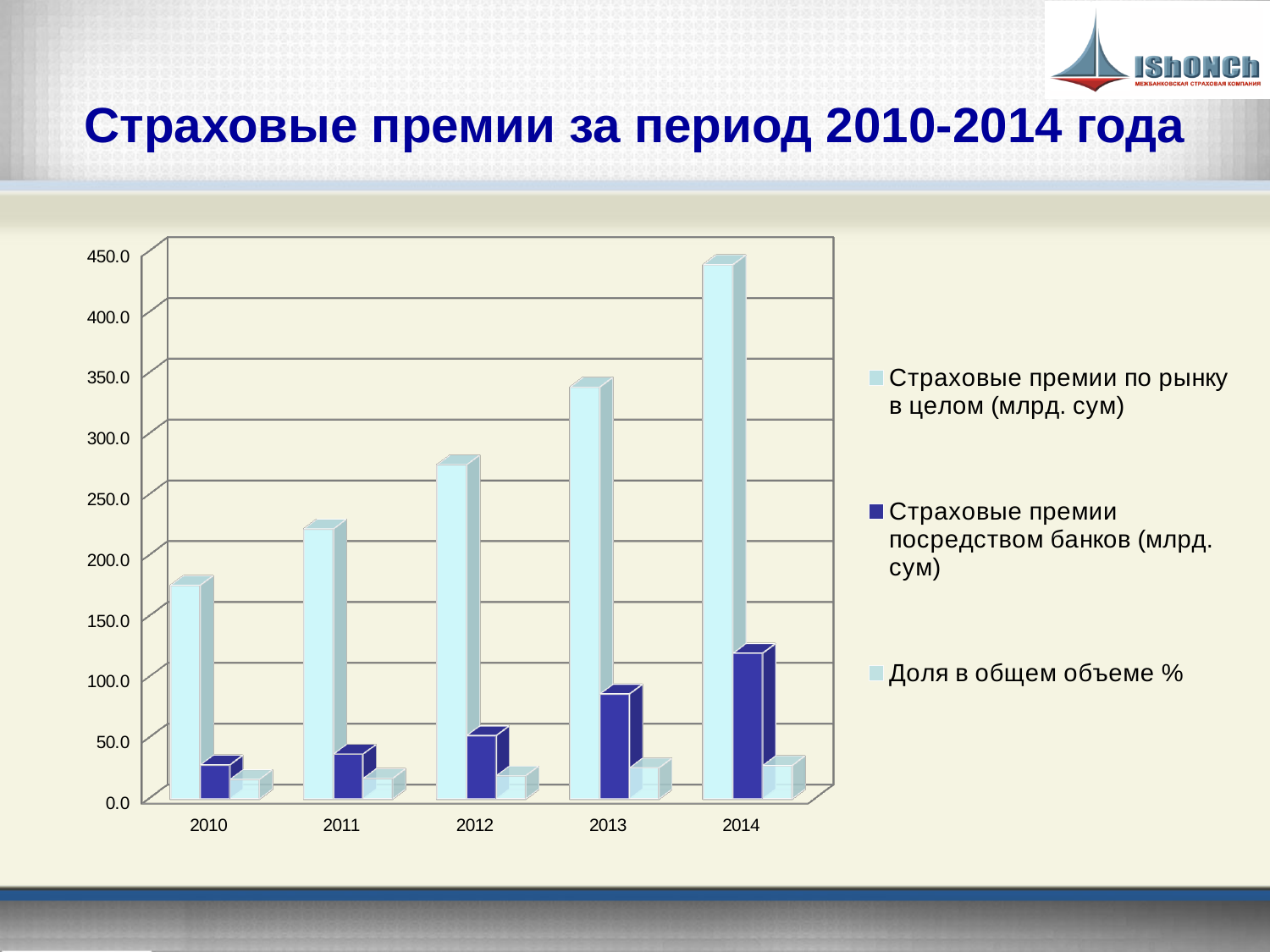
Is the value for 'Страховые премии посредством банков (млрд. сум)' in 2014 greater or less than 100? greater Is the value for 'Страховые премии по рынку в целом (млрд. сум)' in 2014 greater or less than 400? greater Which year has the lowest value for 'Страховые премии посредством банков (млрд. сум)'? 2010 Which year has the highest value for 'Страховые премии по рынку в целом (млрд. сум)'? 2014 How many series does the chart's legend list? 3 Do the values for 'Страховые премии по рынку в целом (млрд. сум)' rise or fall from 2010 to 2014? rise What is the title of the slide containing the chart? Страховые премии за период 2010-2014 года Is the value for 'Страховые премии посредством банков (млрд. сум)' in 2013 greater or less than 100? less What kind of chart is shown on the slide? bar chart Which is larger: 'Страховые премии по рынку в целом (млрд. сум)' in 2012 or in 2013? 2013 How many years are shown on the x axis of the chart? 5